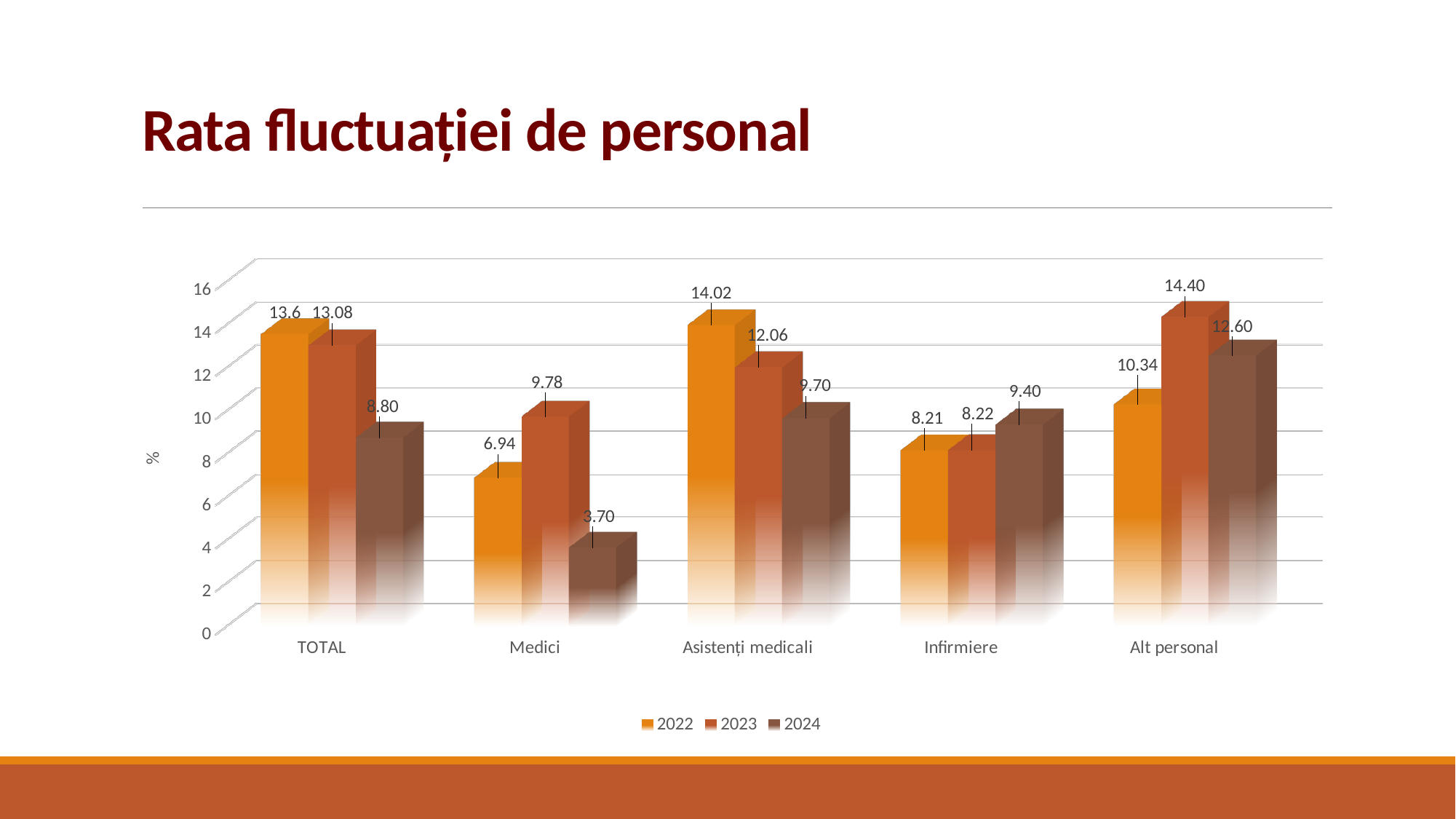
What is the value for Alt personal in 2023? 14.40 What is the difference between the 2023 and 2024 values for Alt personal? 1.80 What is the value for Medici in 2024? 3.70 What is the value for TOTAL in 2022? 13.6 What kind of chart is shown on the slide? Bar chart What is the difference between the 2023 and 2022 values for Medici? 2.84 How many series does the legend list? 3 Which category has the lowest value in the 2024 series? Medici How many categories are shown on the x axis? 5 Which category has the highest value in the 2022 series? Asistenți medicali Do the values for Asistenți medicali rise or fall from 2022 to 2024? Fall Which is larger for Asistenți medicali: the 2022 value or the 2024 value? 2022